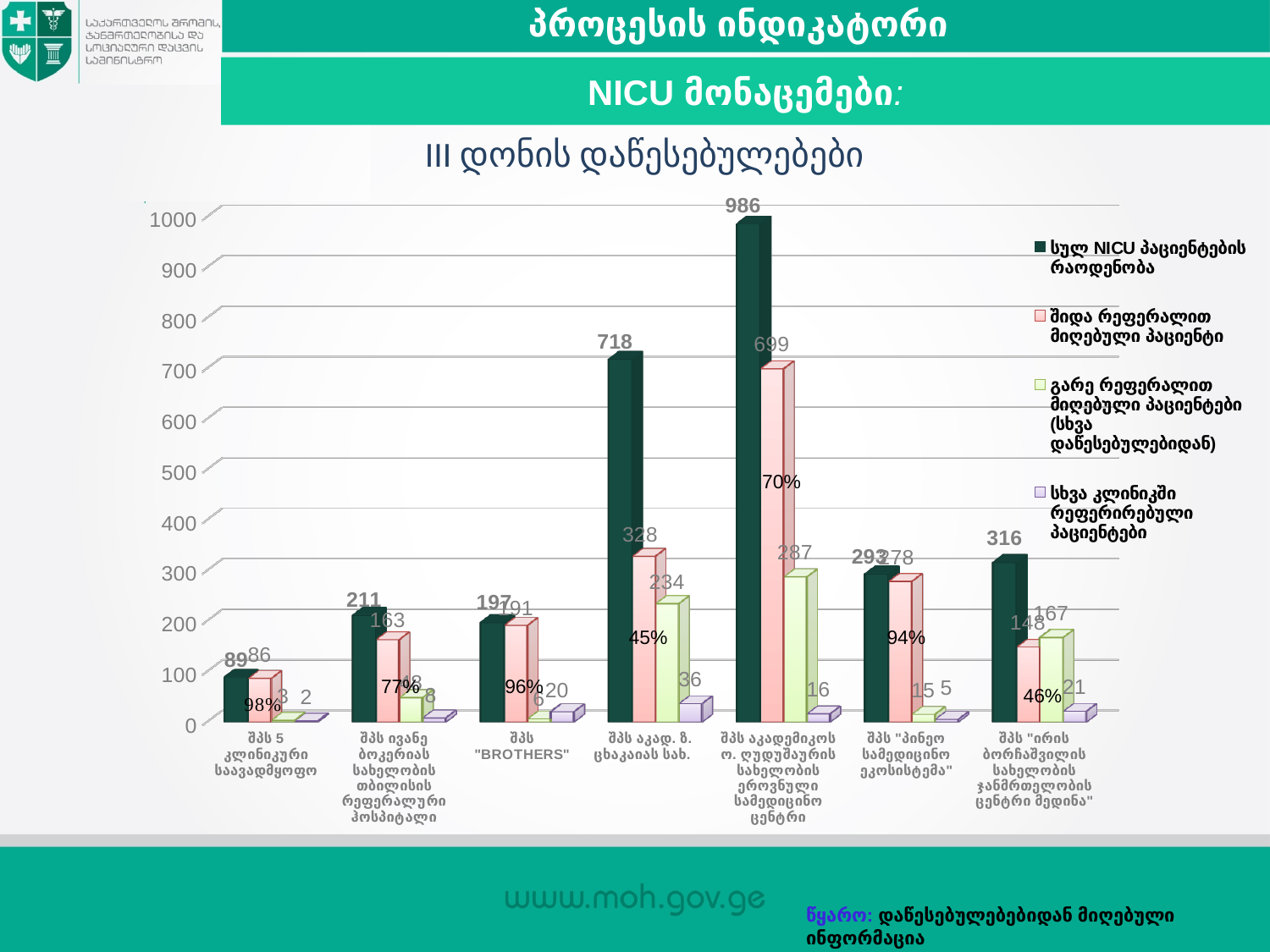
Which institution has the highest value for the dark green series (სულ NICU პაციენტების რაოდენობა)? შპს აკადემიკოს ო. ღუდუშაურის სახელობის ეროვნული სამედიცინო ცენტრი What is the title of the chart? III დონის დაწესებულებები Which institution has the lowest value for the dark green series (სულ NICU პაციენტების რაოდენობა)? შპს 5 კლინიკური საავადმყოფო What percentage label is shown for შპს "BROTHERS"? 96% What is the value of the dark green series (სულ NICU პაციენტების რაოდენობა) for შპს "BROTHERS"? 197 Which is larger: the light green series value for შპს აკად. ზ. ცხაკაიას სახ. or for შპს "ირის ბორჩაშვილის სახელობის ჯანმრთელობის ცენტრი მედინა"? შპს აკად. ზ. ცხაკაიას სახ. Is the dark green series value for შპს აკად. ზ. ცხაკაიას სახ. greater or less than 700? greater What is the difference between the dark green series values for შპს აკადემიკოს ო. ღუდუშაურის სახელობის ეროვნული სამედიცინო ცენტრი (986) and შპს აკად. ზ. ცხაკაიას სახ. (718)? 268 How many categories (institutions) are shown on the x axis? 7 What type of chart is shown on the slide? bar chart What is the value of the pink series (შიდა რეფერალით მიღებული პაციენტი) for შპს აკადემიკოს ო. ღუდუშაურის სახელობის ეროვნული სამედიცინო ცენტრი? 699 How many series does the legend list? 4